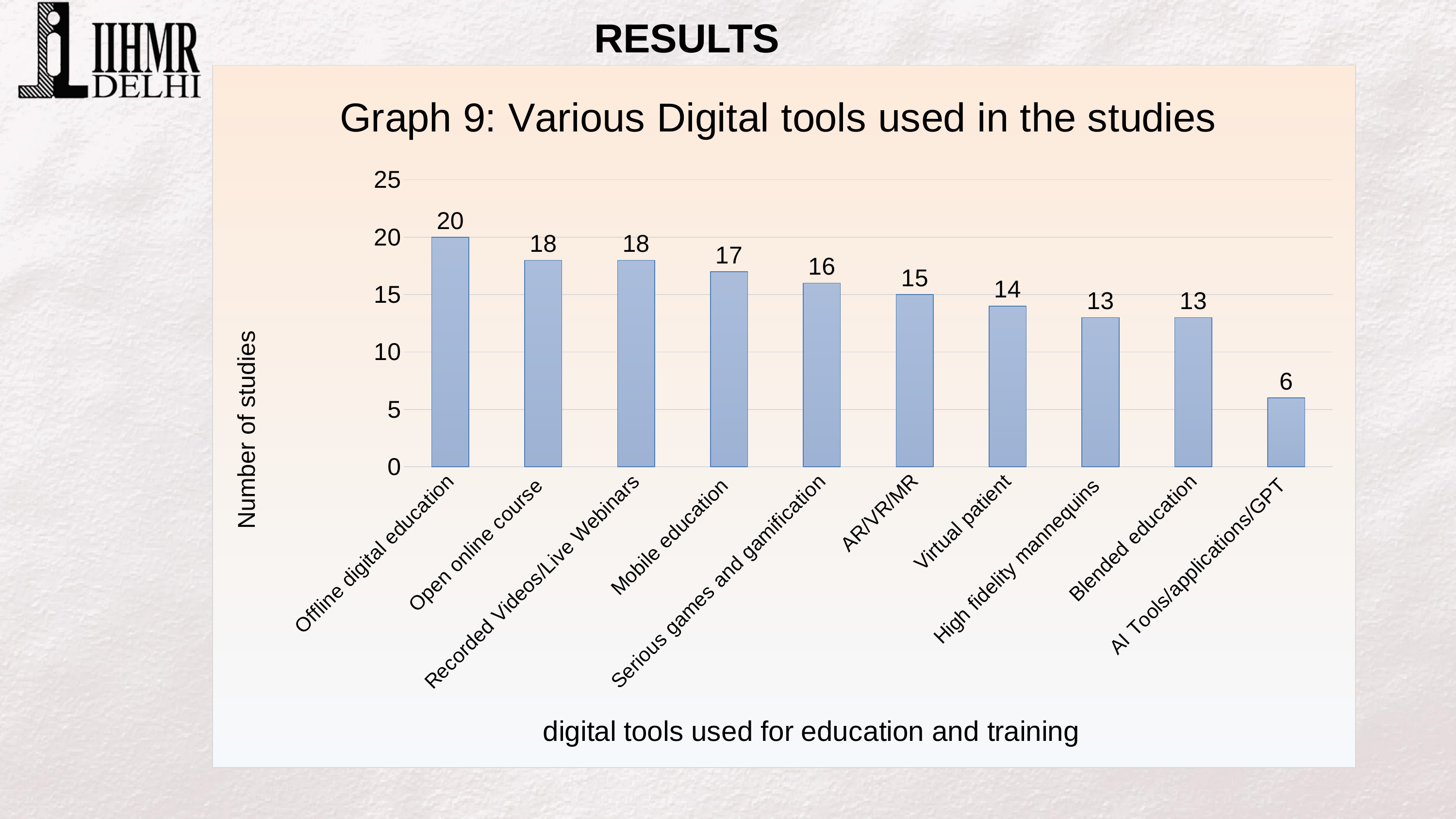
Do the values generally rise or fall from left to right along the x axis? Fall What is the number of studies for AR/VR/MR? 15 How many digital tool categories are shown in the chart? 10 Which digital tool has the lowest number of studies? AI Tools/applications/GPT What is the title of the chart? Graph 9: Various Digital tools used in the studies What is the number of studies for Offline digital education? 20 What is the difference in number of studies between Offline digital education and Virtual patient? 6 Is the value for Blended education greater or less than 10? greater What kind of chart is shown on the slide? Bar chart What is the number of studies for AI Tools/applications/GPT? 6 Which digital tool has the highest number of studies? Offline digital education Which has more studies, Mobile education or Serious games and gamification? Mobile education